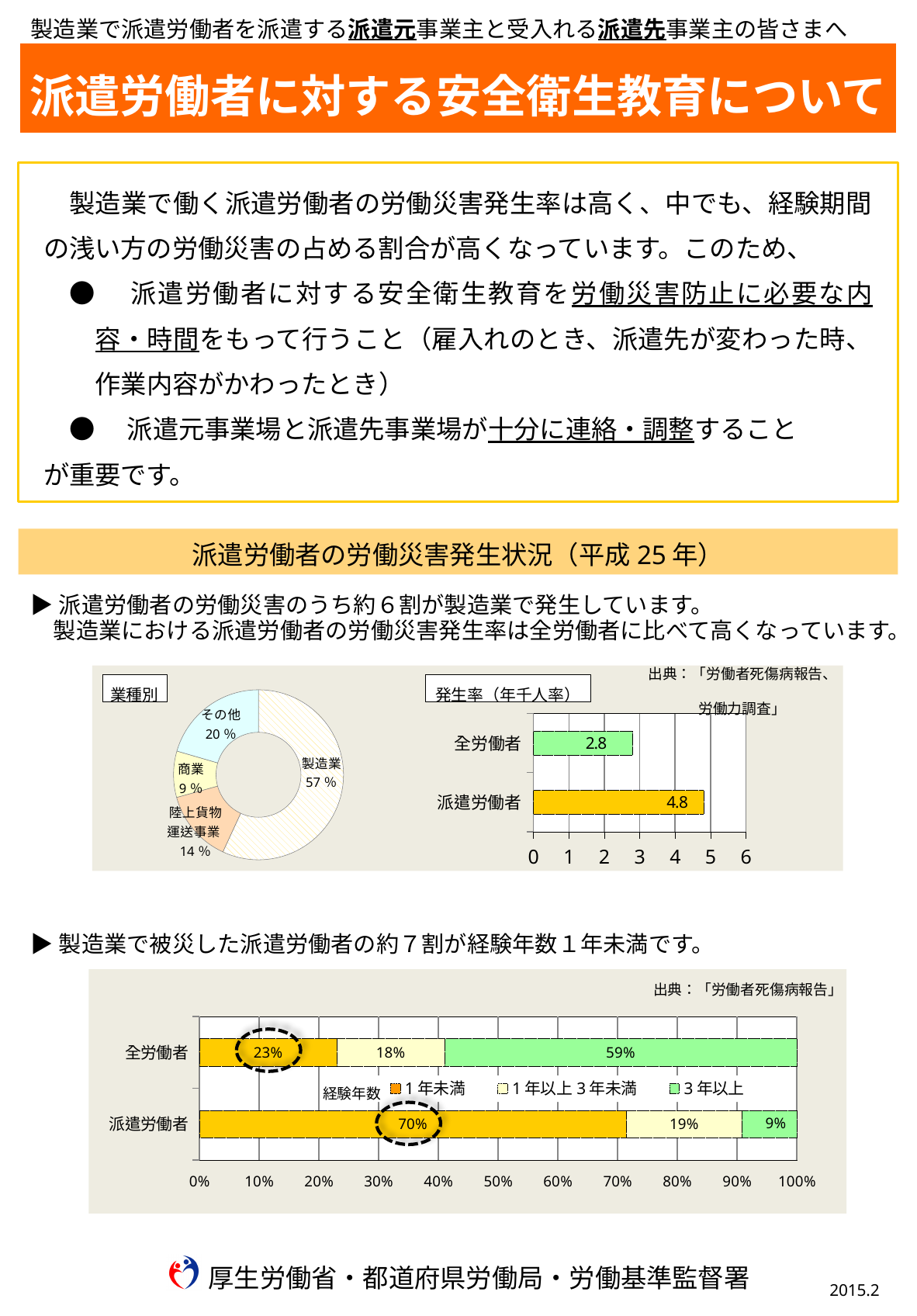
In the 発生率（年千人率） chart, which is larger, 全労働者 or 派遣労働者? 派遣労働者 In the 業種別 pie chart, which category has the smallest share? 商業 In the bottom stacked bar chart on 経験年数, what is the 1年未満 share for 派遣労働者? 70% In the 発生率（年千人率） chart, what is the difference between 派遣労働者 and 全労働者? 2.0 In the 業種別 pie chart, how many categories are shown? 4 In the 業種別 pie chart, what is the difference between the shares of その他 and 陸上貨物運送事業? 6% In the 業種別 pie chart, what share does 製造業 have? 57% In the bottom stacked bar chart on 経験年数, what is the 3年以上 share for 全労働者? 59% In the bottom stacked bar chart on 経験年数, what is the total of the 派遣労働者 bar? 98% In the 発生率（年千人率） chart, what is the value for 派遣労働者? 4.8 What kind of chart is the 発生率（年千人率） chart? Bar chart In the bottom stacked bar chart on 経験年数, how many series does the legend list? 3